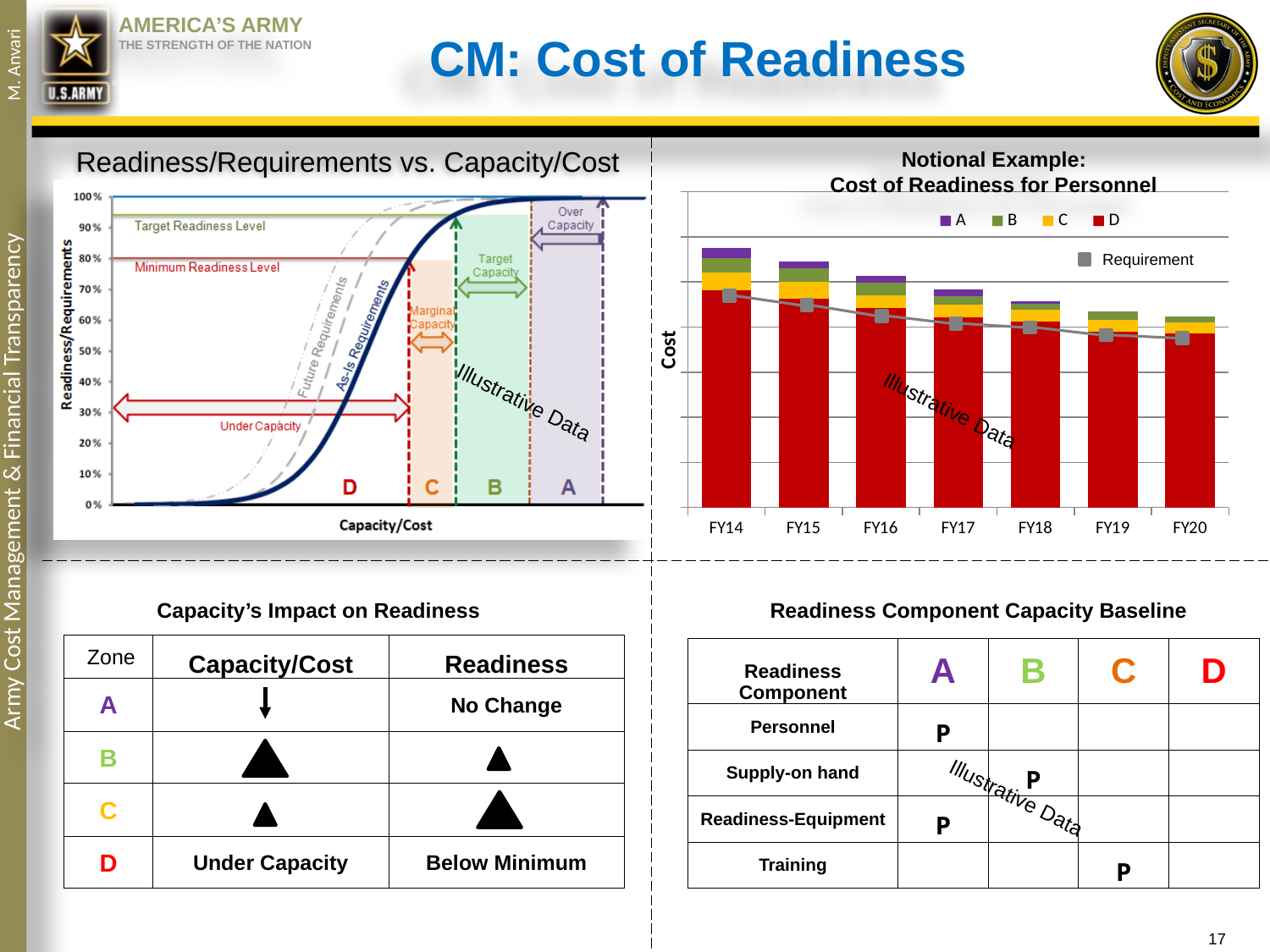
In the 'Cost of Readiness for Personnel' bar chart, which fiscal year has the tallest stacked bar? FY14 In the 'Cost of Readiness for Personnel' bar chart, which fiscal year has the shortest stacked bar? FY20 In the 'Readiness/Requirements vs. Capacity/Cost' chart on the left, at what readiness level is the Minimum Readiness Level line drawn? 80% In the 'Cost of Readiness for Personnel' bar chart, what is the label of the grey line series plotted across the bars? Requirement In the 'Readiness/Requirements vs. Capacity/Cost' chart on the left, what is the label of the x axis? Capacity/Cost What type of chart is the 'Notional Example: Cost of Readiness for Personnel' chart on the right? Stacked bar chart In the 'Cost of Readiness for Personnel' bar chart, do the stacked bars rise or fall from FY14 to FY20? Fall In the 'Cost of Readiness for Personnel' bar chart, which series makes up the largest portion of each stacked bar? D In the 'Readiness/Requirements vs. Capacity/Cost' chart on the left, how many lettered zones (D, C, B, A) are marked along the x axis? 4 In the 'Cost of Readiness for Personnel' bar chart, which series is shown in red? D In the 'Readiness/Requirements vs. Capacity/Cost' chart on the left, at what readiness level is the Target Readiness Level line drawn? 90% How many fiscal years are shown on the x axis of the 'Cost of Readiness for Personnel' bar chart? 7